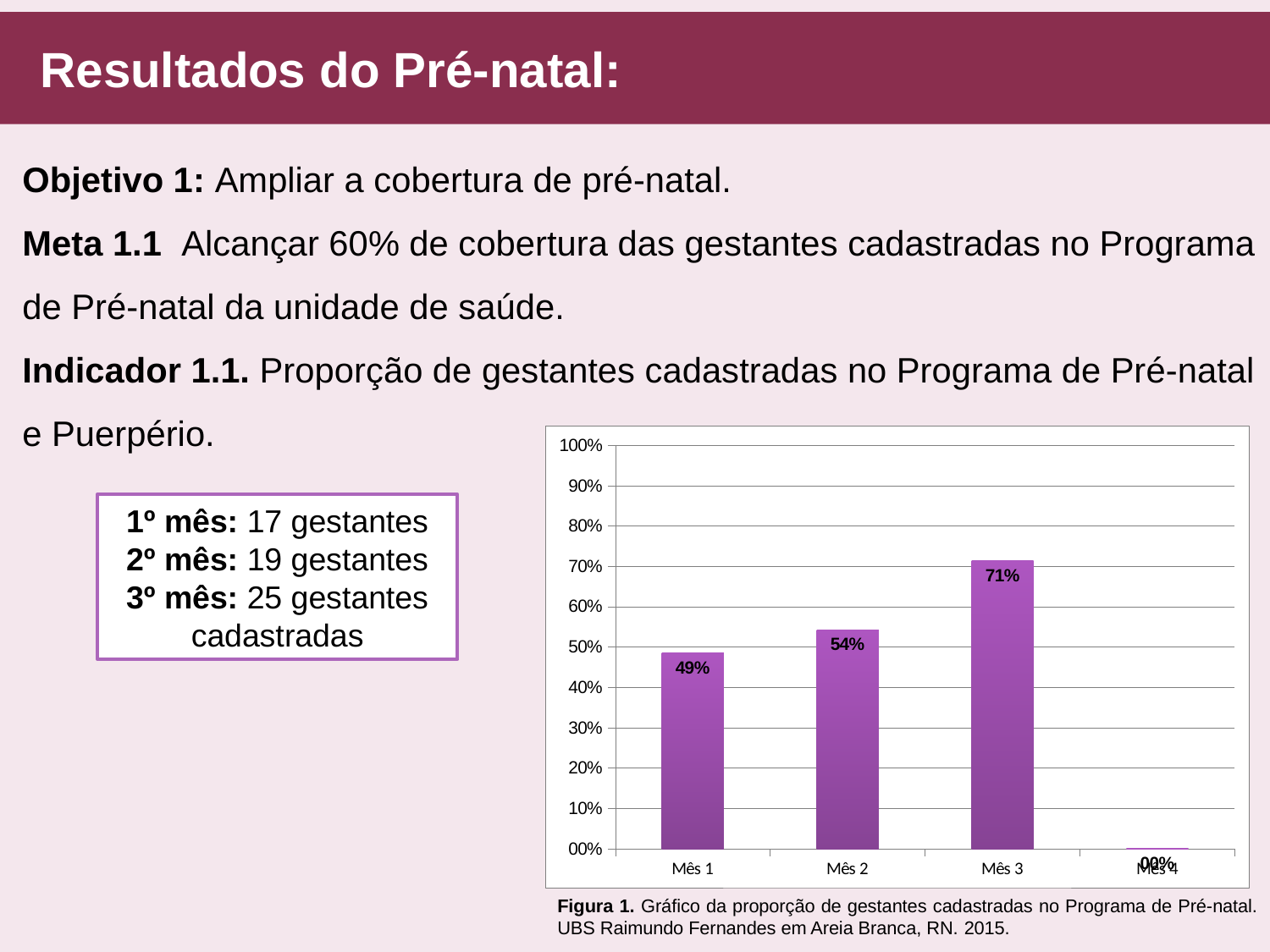
Is the value for Mês 3 greater or less than 60%? greater What is the value for Mês 3 in the chart? 71% What is the difference between the values for Mês 3 and Mês 1? 22 percentage points What is the value for Mês 2 in the chart? 54% Which is larger, the value for Mês 2 or the value for Mês 3? Mês 3 What is the difference between the values for Mês 2 and Mês 1? 5 percentage points Which month has the highest proportion in the chart? Mês 3 Which month has the lowest value in the chart? Mês 4 What kind of chart is shown on the slide? Bar chart What is the value for Mês 1 in the chart? 49% Do the values rise or fall from Mês 1 to Mês 3? Rise How many month categories are shown on the x axis of the chart? 4